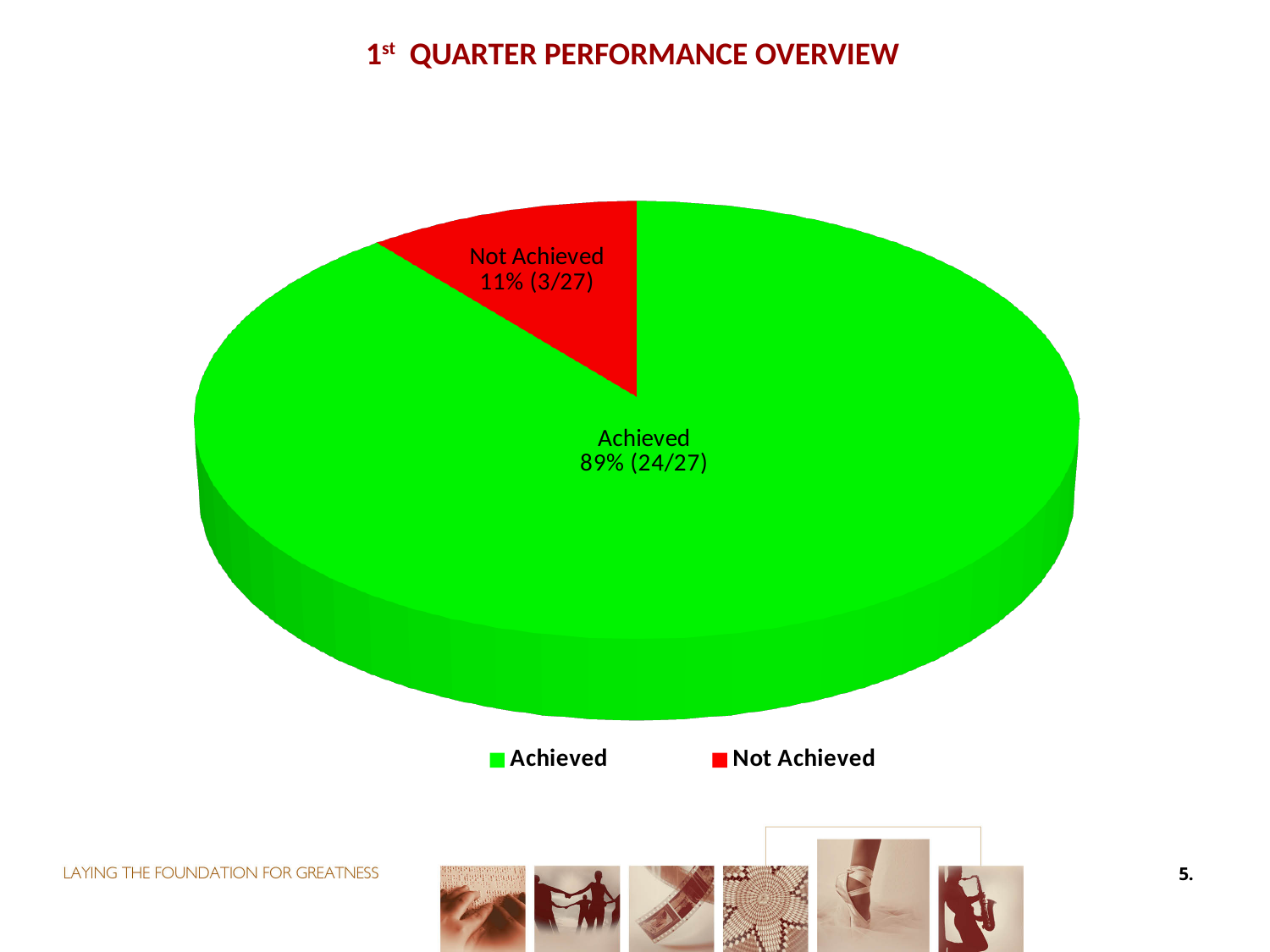
What percentage of the pie is labelled Achieved? 89% Which slice of the pie is the smallest? Not Achieved How many slices does the pie chart have? 2 What colour is the Not Achieved slice? Red Which slice of the pie is the largest? Achieved How many items out of 27 were achieved according to the chart? 24 Which is larger, the Achieved slice or the Not Achieved slice? Achieved What is the difference in percentage points between the Achieved and Not Achieved slices? 78 What percentage of the pie is labelled Not Achieved? 11% How many entries does the legend list? 2 How many items out of 27 were not achieved according to the chart? 3 What kind of chart is shown on the slide? Pie chart